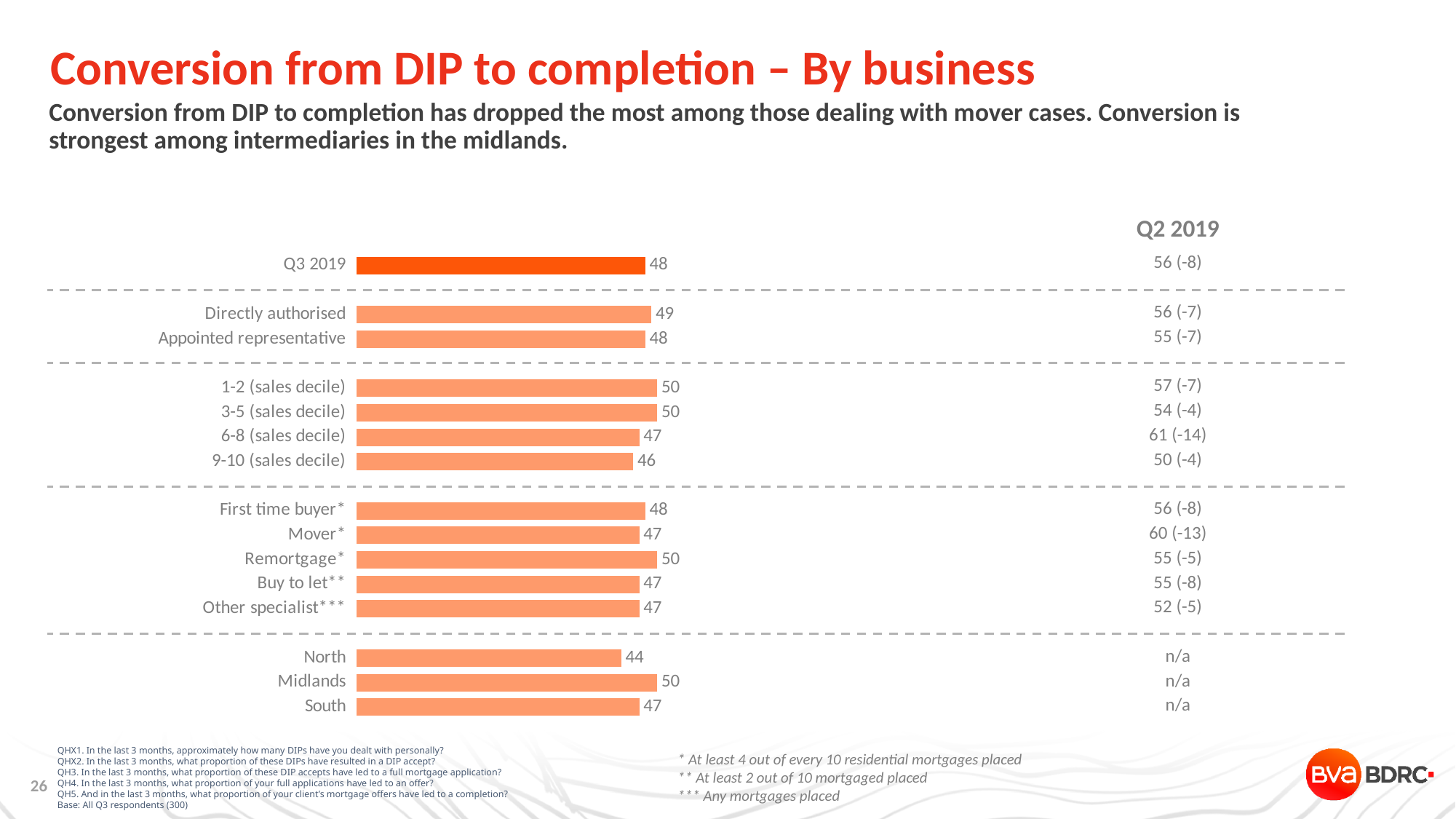
How many bars are plotted in the chart? 15 What is the value for Directly authorised? 49 What is the value for Midlands? 50 What kind of chart is shown on the slide? bar chart What is the value for Q3 2019 overall? 48 What is the value for Mover? 47 What is the value for 9-10 (sales decile)? 46 Which category has the lowest value? North What is the difference between the values for Directly authorised and North? 5 Which is larger, the value for Midlands or the value for North? Midlands What is the difference between the values for Midlands and South? 3 What Q2 2019 value is shown for Mover in the right-hand column? 60 (-13)